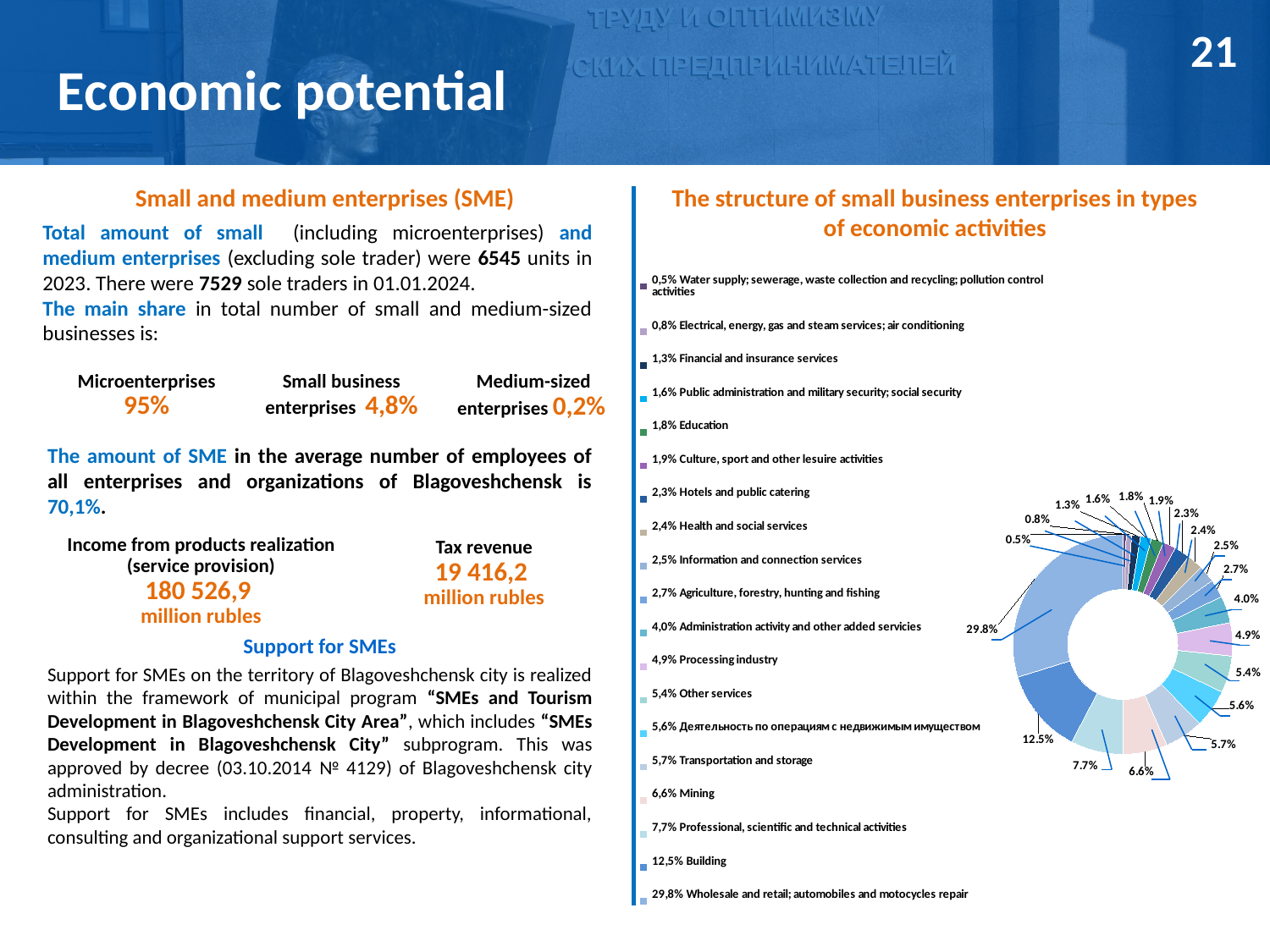
What is the difference between the share of Wholesale and retail; automobiles and motocycles repair and the share of Building? 17.3% What kind of chart is used to show the structure of small business enterprises? doughnut chart How many percentage points larger is the share of Building than the share of Professional, scientific and technical activities? 4.8% What is the title of the chart on the slide? The structure of small business enterprises in types of economic activities How many types of economic activity are listed in the chart legend? 19 What share of small business enterprises is in Education? 1.8% What share of small business enterprises is in Mining? 6.6% Which has a larger share: Processing industry or Administration activity and other added servicies? Processing industry What share of small business enterprises is in Building? 12.5% Which type of economic activity has the smallest share of small business enterprises? Water supply; sewerage, waste collection and recycling; pollution control activities What share of small business enterprises is in Transportation and storage? 5.7% Which type of economic activity has the largest share of small business enterprises? Wholesale and retail; automobiles and motocycles repair